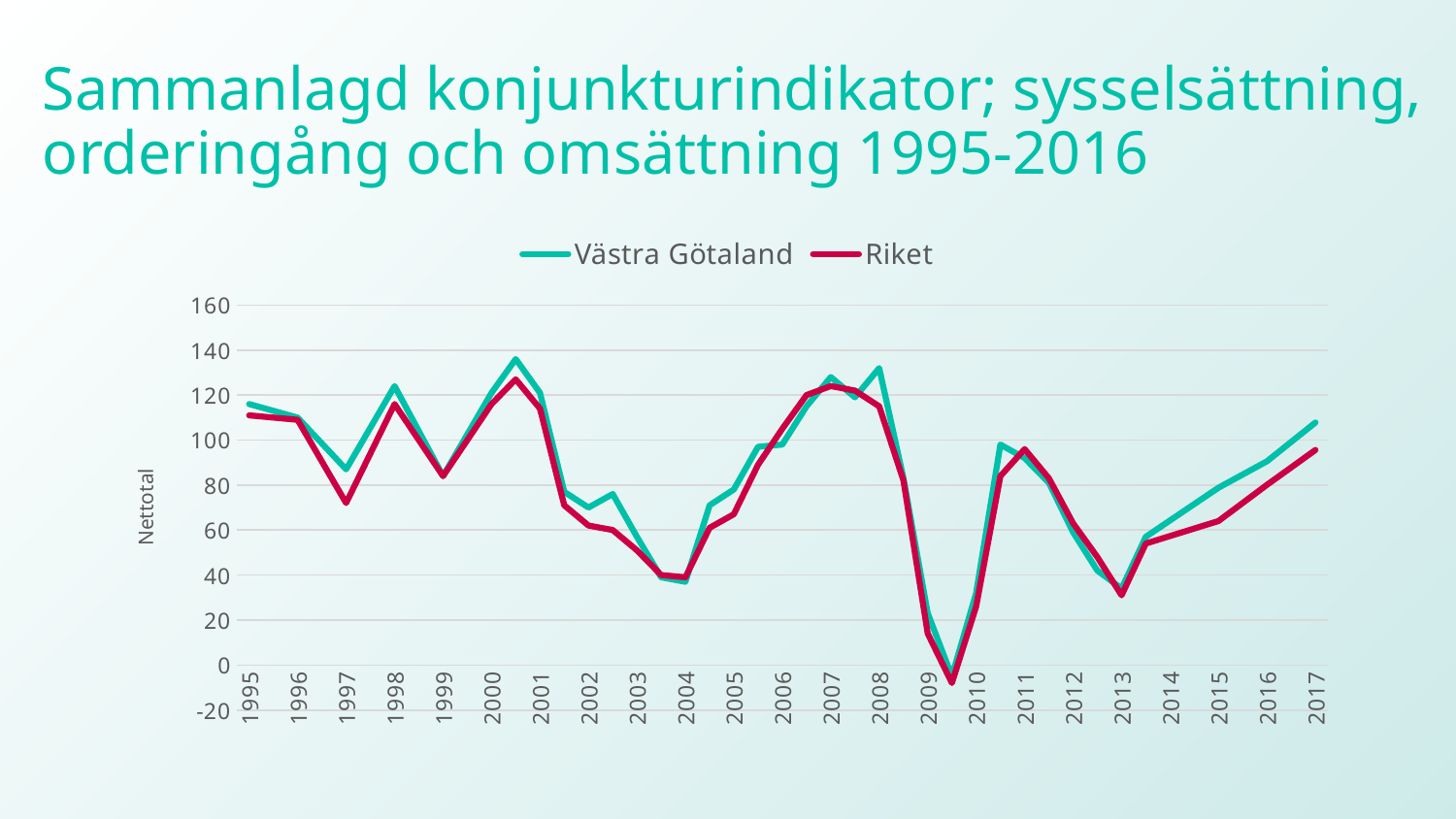
Is the value for Riket in 2004 greater or less than 60? less Do the values for both series rise or fall between 2013 and 2017? rise In 2017, which series has the higher value, Västra Götaland or Riket? Västra Götaland In 1997, which series has the higher value, Västra Götaland or Riket? Västra Götaland How many years are labelled along the x axis? 23 What kind of chart is shown on the slide? line chart Is the value for Riket in 2017 greater or less than 100? less What is the label on the vertical axis? Nettotal Is the value for Västra Götaland in 2017 greater or less than 100? greater How many series does the legend list? 2 What are the two series named in the legend? Västra Götaland and Riket